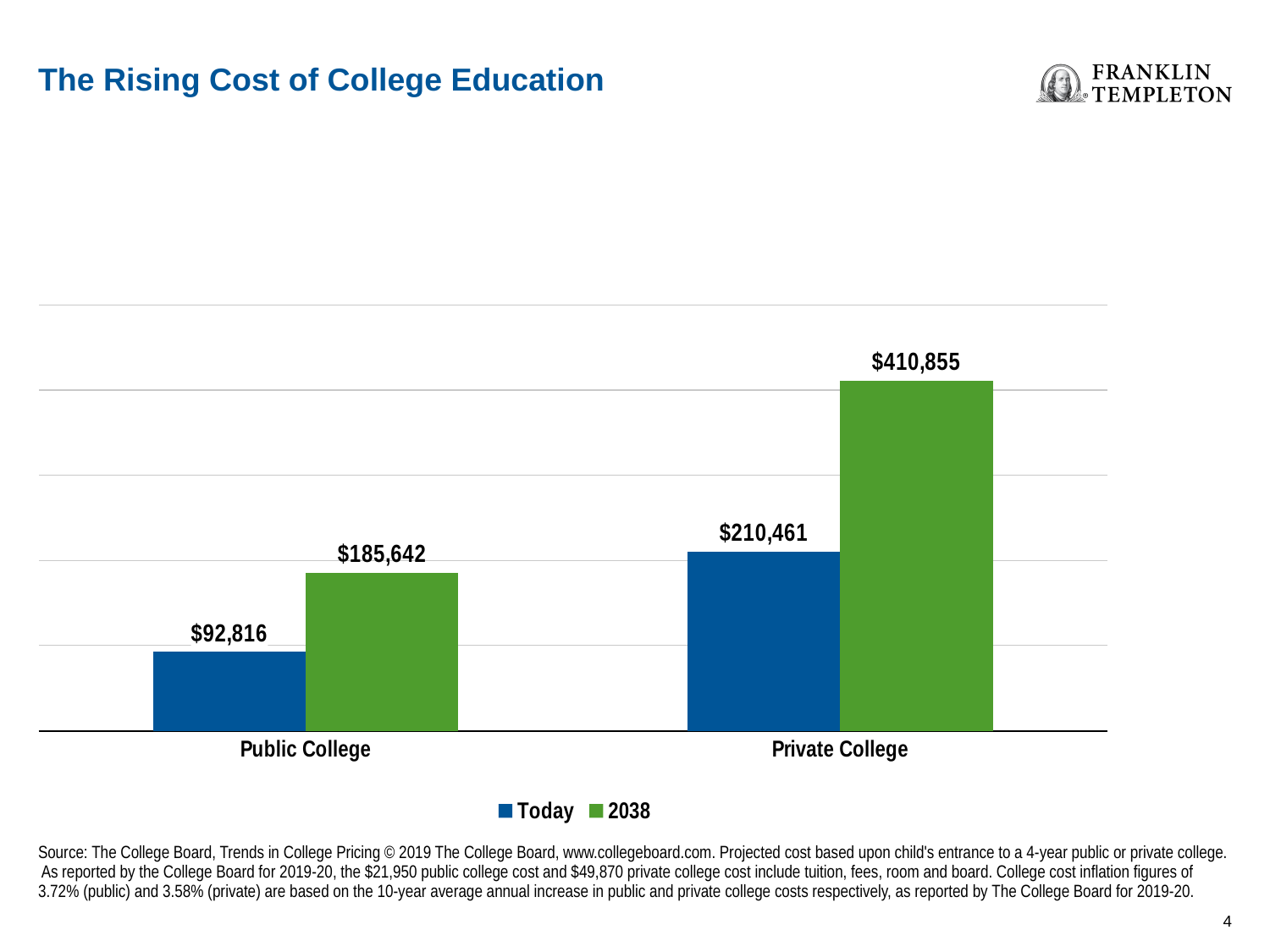
Which bar shows the lowest value on the chart? Public College, Today What is the Today value for Public College? $92,816 What kind of chart is shown on the slide? Bar chart What is the difference between the 2038 and Today values for Public College? $92,826 How many series does the legend list? 2 Which is larger: the 2038 value for Public College or the Today value for Private College? Today value for Private College Which bar shows the highest value on the chart? Private College, 2038 What is the 2038 value for Public College? $185,642 How many categories are shown on the x axis? 2 What is the Today value for Private College? $210,461 What is the difference between the 2038 and Today values for Private College? $200,394 What is the 2038 value for Private College? $410,855